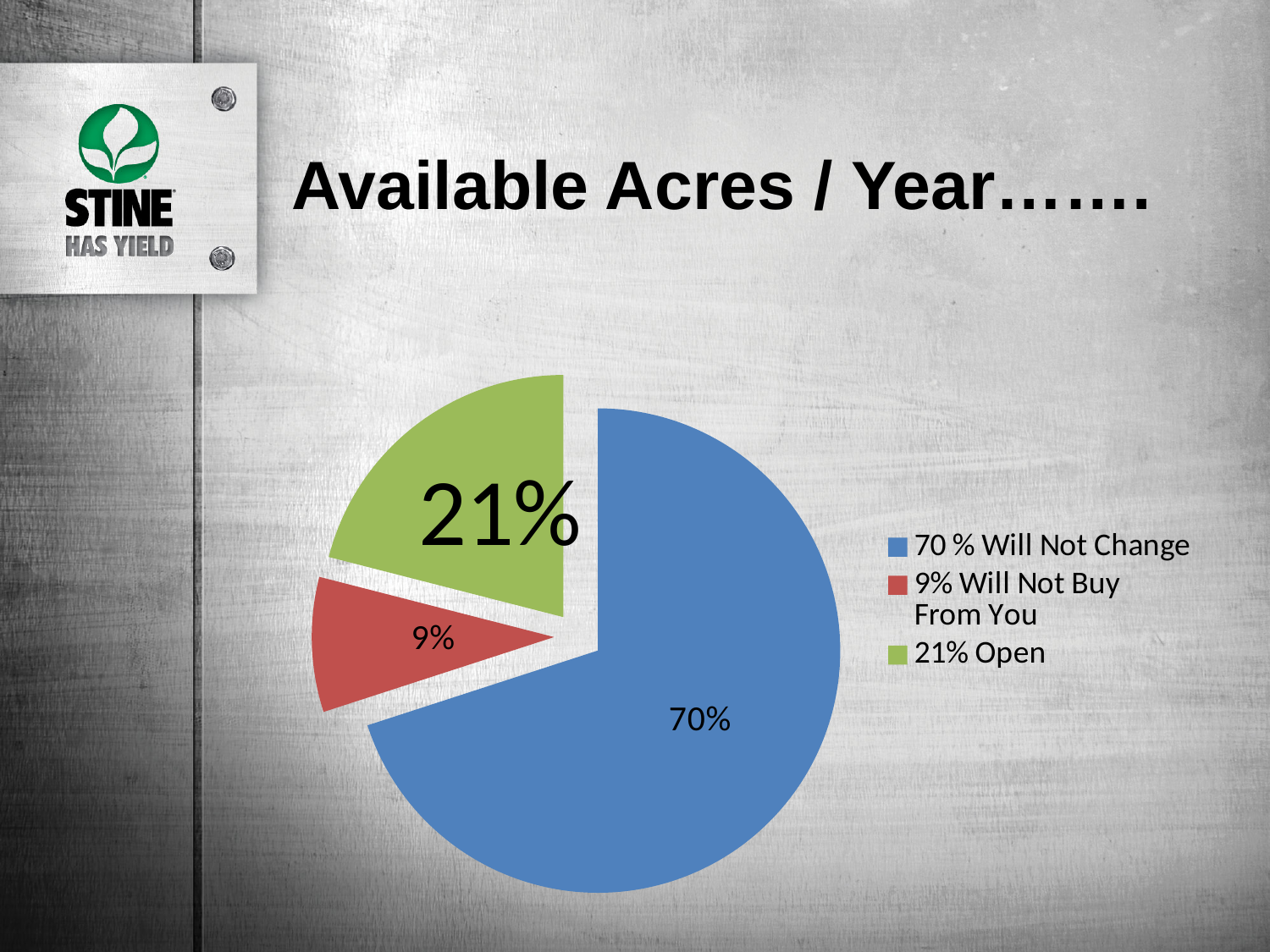
What is the title of the slide containing the pie chart? Available Acres / Year……. Which is larger, the "Open" slice or the "Will Not Buy From You" slice? 21% Open What percentage of the pie is labelled "Open"? 21% How many entries does the legend list? 3 What is the difference in percentage points between the "Will Not Change" slice and the "Open" slice? 49 Which slice of the pie is the smallest? 9% Will Not Buy From You How many slices does the pie chart have? 3 What percentage of the pie is labelled "Will Not Buy From You"? 9% What percentage of the pie is labelled "Will Not Change"? 70% What kind of chart is shown on the slide? pie chart Which slice of the pie is the largest? 70 % Will Not Change What colour is the "Open" slice of the pie? green